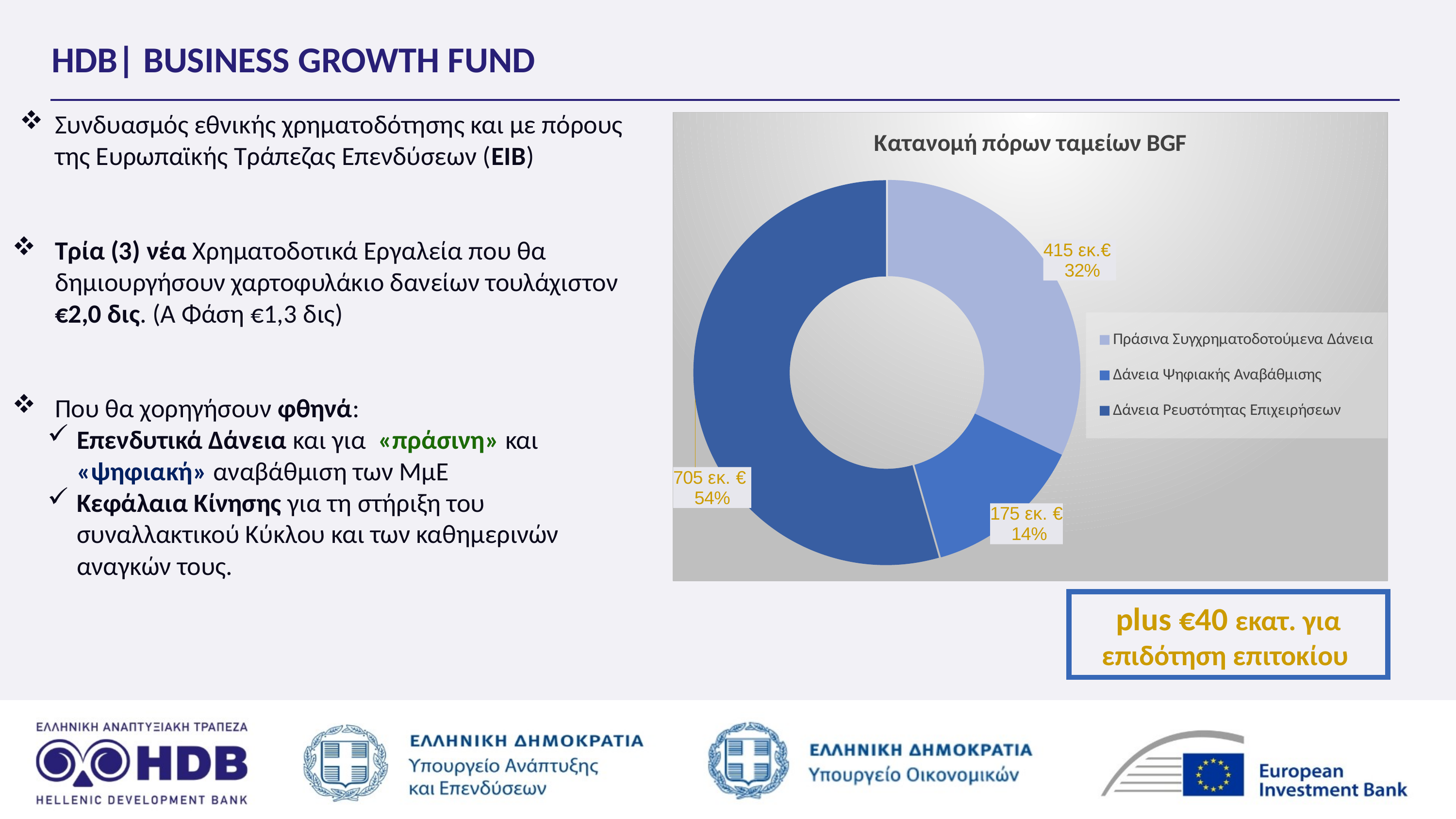
Which category has the largest share of the chart? Δάνεια Ρευστότητας Επιχειρήσεων What is the difference in value between Δάνεια Ρευστότητας Επιχειρήσεων and Δάνεια Ψηφιακής Αναβάθμισης? 530 εκ. € What percentage share does Δάνεια Ρευστότητας Επιχειρήσεων have? 54% What is the title of the chart? Κατανομή πόρων ταμείων BGF Which is larger, the value for Πράσινα Συγχρηματοδοτούμενα Δάνεια or for Δάνεια Ψηφιακής Αναβάθμισης? Πράσινα Συγχρηματοδοτούμενα Δάνεια What is the value for Δάνεια Ρευστότητας Επιχειρήσεων? 705 εκ. € How many categories does the chart show? 3 What is the value for Δάνεια Ψηφιακής Αναβάθμισης? 175 εκ. € What is the value for Πράσινα Συγχρηματοδοτούμενα Δάνεια? 415 εκ.€ Which category has the smallest share of the chart? Δάνεια Ψηφιακής Αναβάθμισης What kind of chart is shown on the slide? Doughnut (pie) chart What percentage share does Πράσινα Συγχρηματοδοτούμενα Δάνεια have? 32%